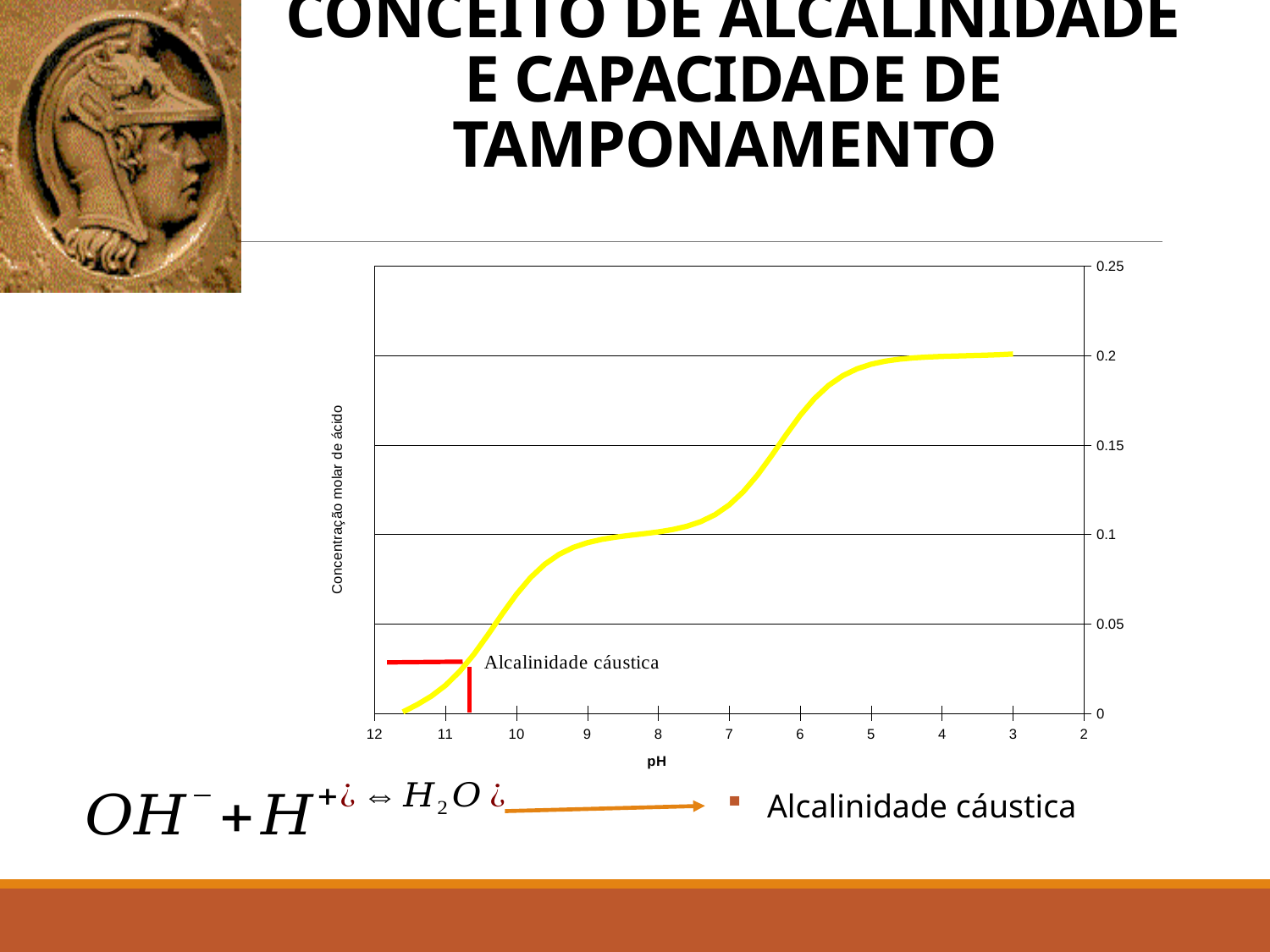
How many curves are plotted on the chart? 1 Which is larger, the value of the curve at pH 5 or at pH 9? pH 5 Does the plotted curve rise or fall from left to right across the chart? rise Is the value of the curve at pH 10 greater or less than 0.05? greater Is the value of the curve at pH 11 greater or less than 0.05? less Which is larger, the value of the curve at pH 11 or at pH 8? pH 8 What is the highest value shown on the y axis of the chart? 0.25 What is the label of the y axis of the chart? Concentração molar de ácido What kind of chart is shown on the slide? line chart Is the value of the curve at pH 7 greater or less than 0.15? less What is the label of the x axis of the chart? pH